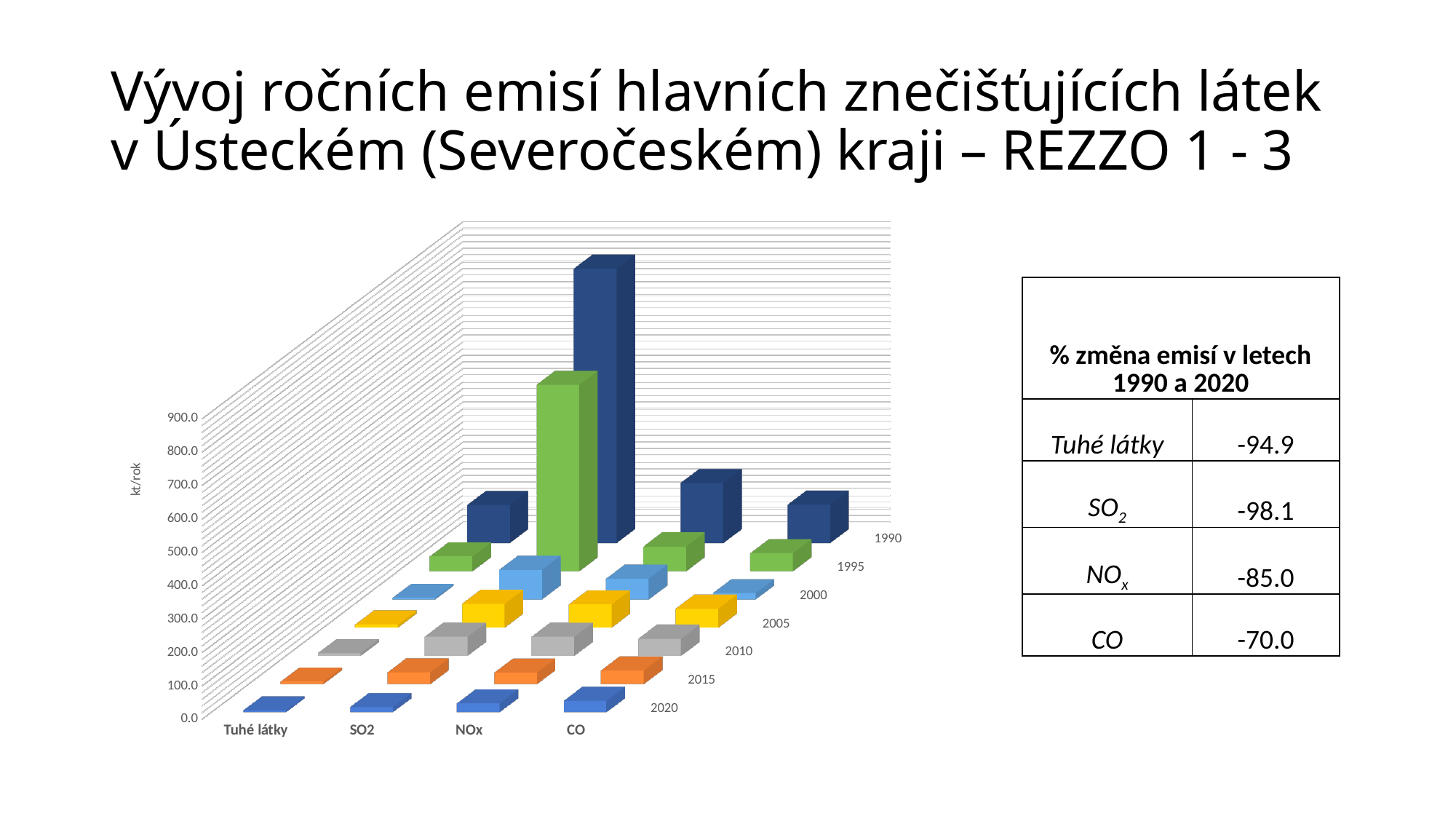
Which pollutant has the tallest bar for 1995? SO2 Which is larger in 1990, the SO2 bar or the NOx bar? SO2 Which year has the highest SO2 bar? 1990 What kind of chart is shown on the slide? bar chart Which is larger for CO, the 1990 bar or the 2020 bar? 1990 Is the SO2 value for 1990 greater or less than 500? greater Do the SO2 bars rise or fall from 1990 to 2020? fall What unit is shown on the vertical axis of the chart? kt/rok Which pollutant has the tallest bar for 1990? SO2 How many years are plotted in the chart? 7 Is the value for Tuhé látky in 1990 greater or less than 500? less How many pollutant categories are shown along the x axis of the chart? 4